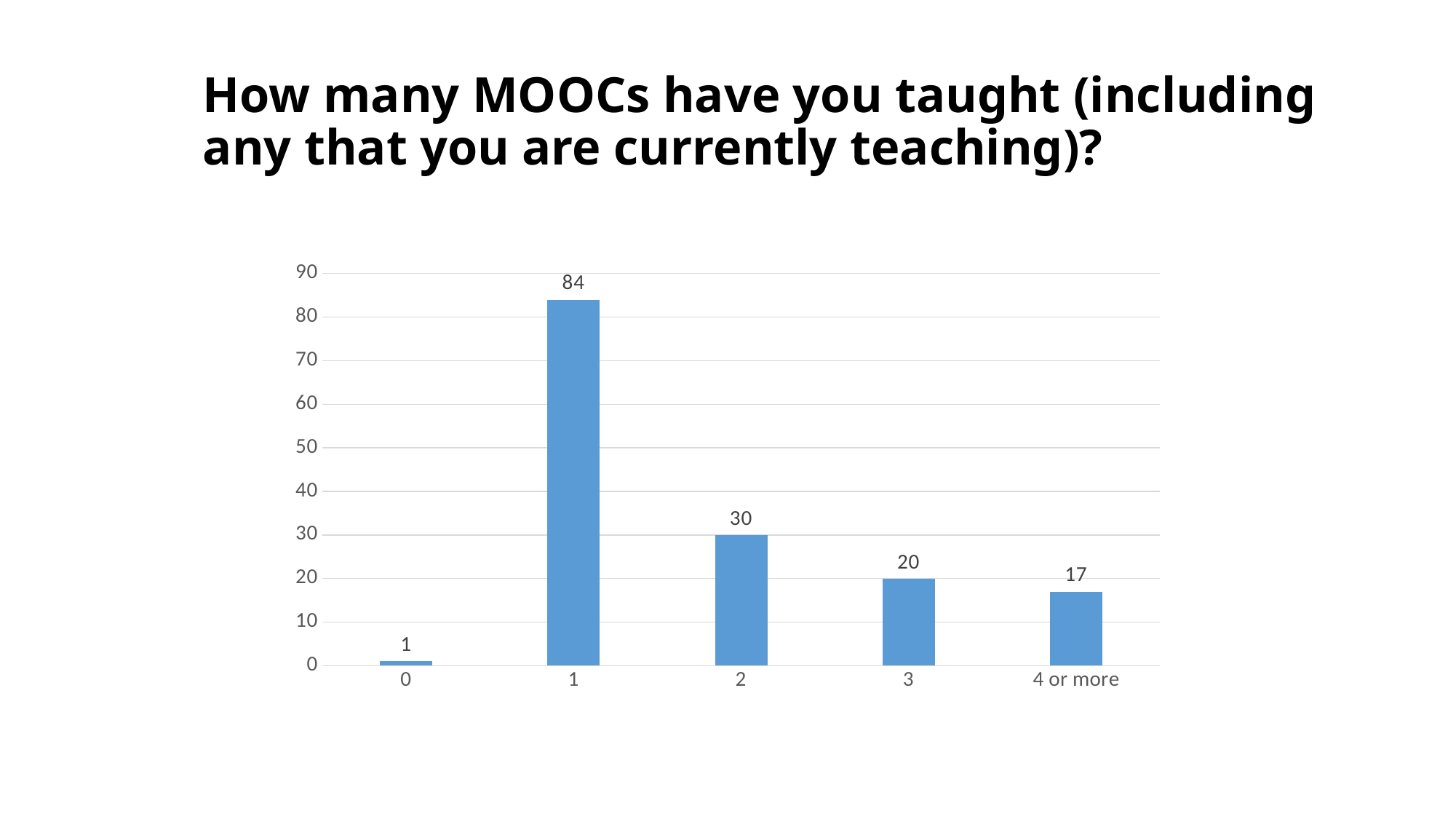
What is the value for the category "1"? 84 What is the value for the category "0"? 1 Which category has the lowest value? 0 What is the title of the chart? How many MOOCs have you taught (including any that you are currently teaching)? How many categories are shown on the x axis? 5 Which category has the highest value? 1 What is the value for the category "4 or more"? 17 What is the difference between the values for "3" and "4 or more"? 3 What is the difference between the values for "1" and "2"? 54 What kind of chart is shown on the slide? bar chart Which is larger, the value for "2" or the value for "3"? 2 Is the value for "2" greater or less than 40? less